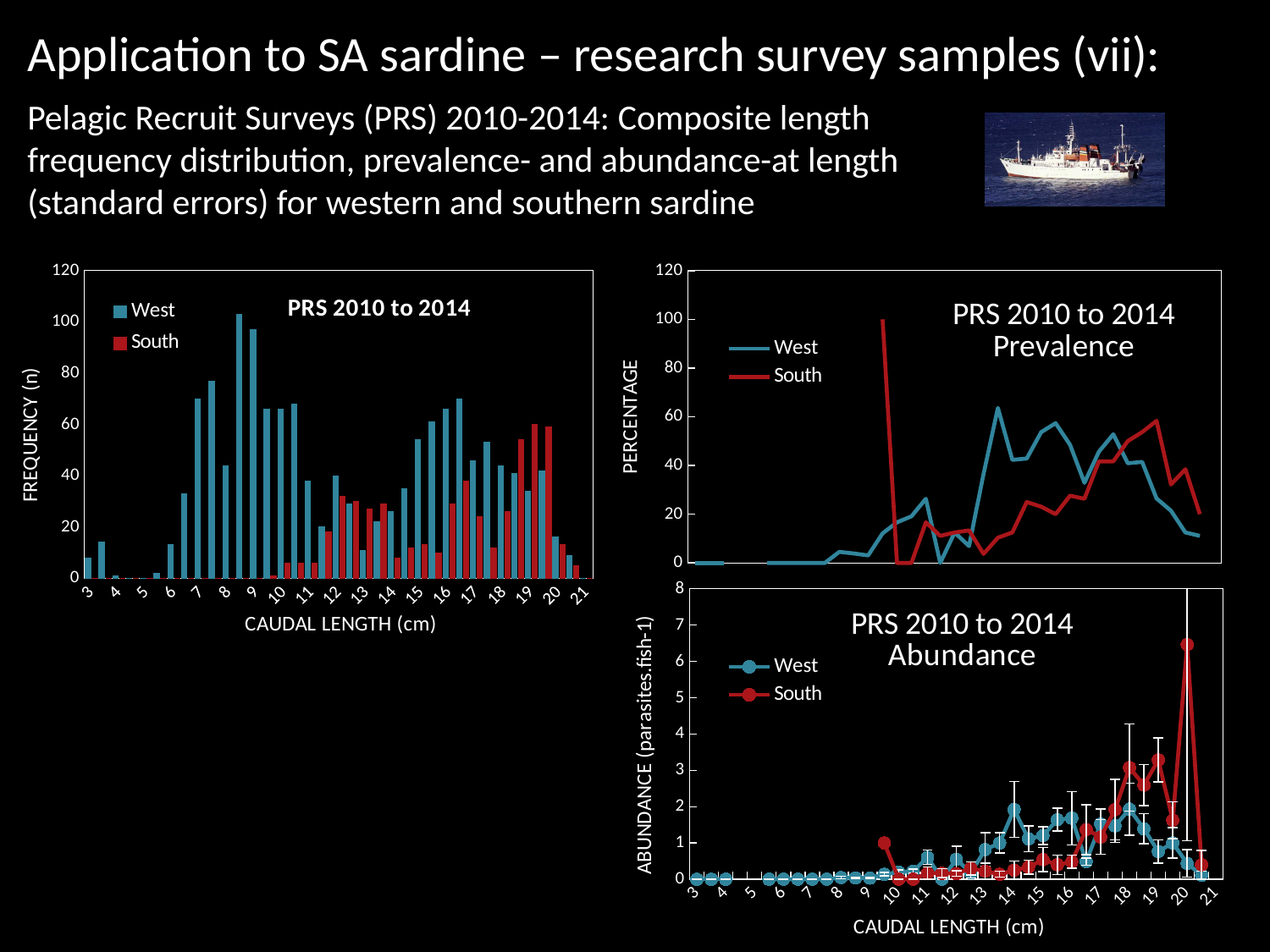
In the left bar chart, is the tallest West bar greater or less than 80? greater In the 'PRS 2010 to 2014 Abundance' chart, which series reaches the highest value? South In the 'PRS 2010 to 2014 Prevalence' chart, is the peak value of the West line greater or less than 80? less In the 'PRS 2010 to 2014 Abundance' chart, is the South value at 20 cm greater or less than 5? greater How many series does the legend of the left bar chart list? 2 What kind of chart is the 'PRS 2010 to 2014' chart on the left of the slide? bar chart What kind of chart is the 'PRS 2010 to 2014 Prevalence' chart? line chart In the left bar chart, which series has the tallest bar? West What is the x-axis label on the 'PRS 2010 to 2014 Abundance' chart? CAUDAL LENGTH (cm)